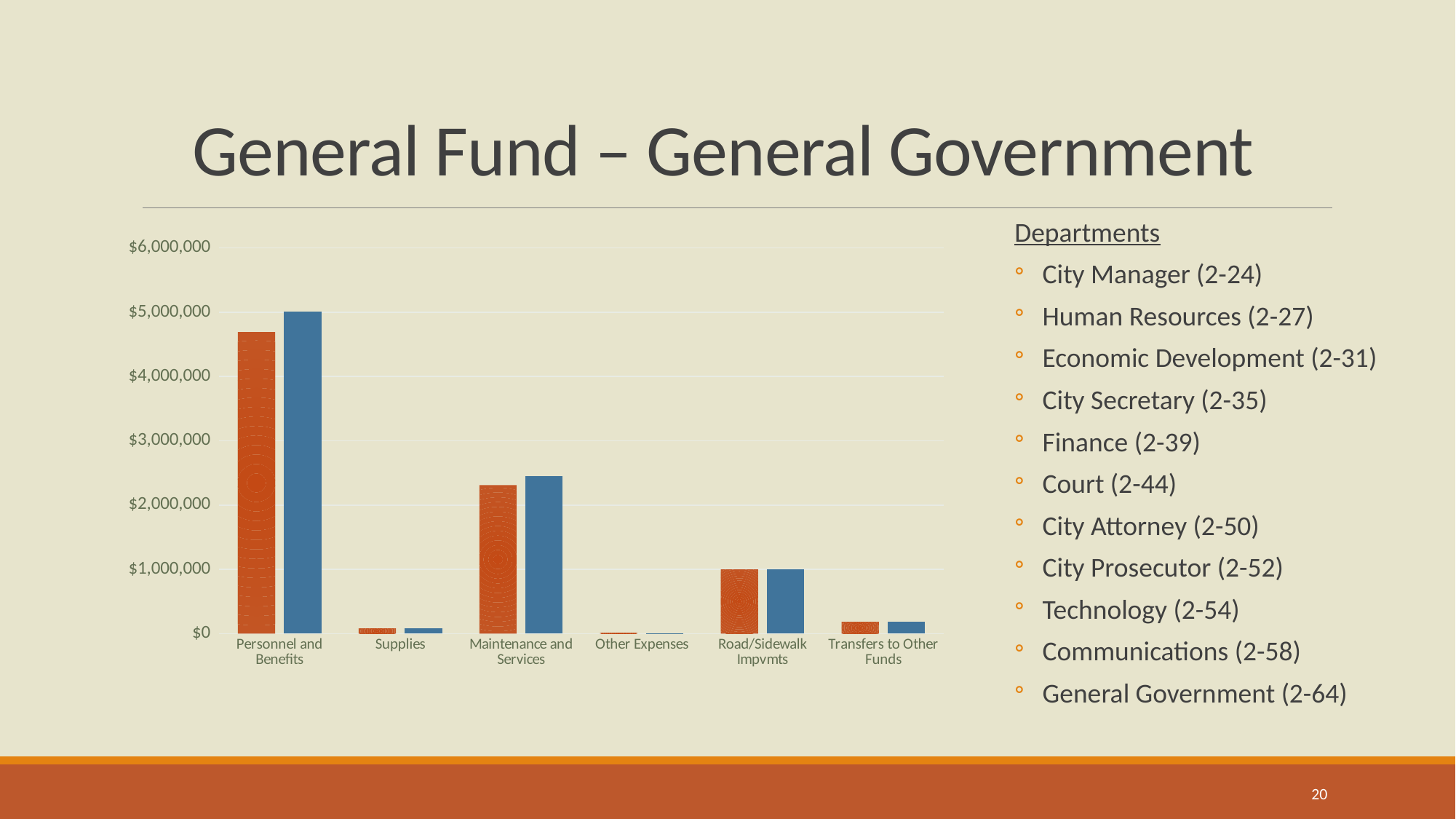
Is the value for Supplies greater or less than $1,000,000? less Which category has the shortest bars in the chart? Other Expenses Is the blue bar for Maintenance and Services greater or less than $2,000,000? greater How many categories are shown on the x axis of the chart? 6 Is the blue bar for Personnel and Benefits greater or less than $4,000,000? greater What kind of chart is shown on the slide? bar chart How many bars are plotted for each category in the chart? 2 Which category has the tallest bars in the chart? Personnel and Benefits Which is larger for Personnel and Benefits, the orange bar or the blue bar? the blue bar Which category has larger values, Maintenance and Services or Road/Sidewalk Impvmts? Maintenance and Services